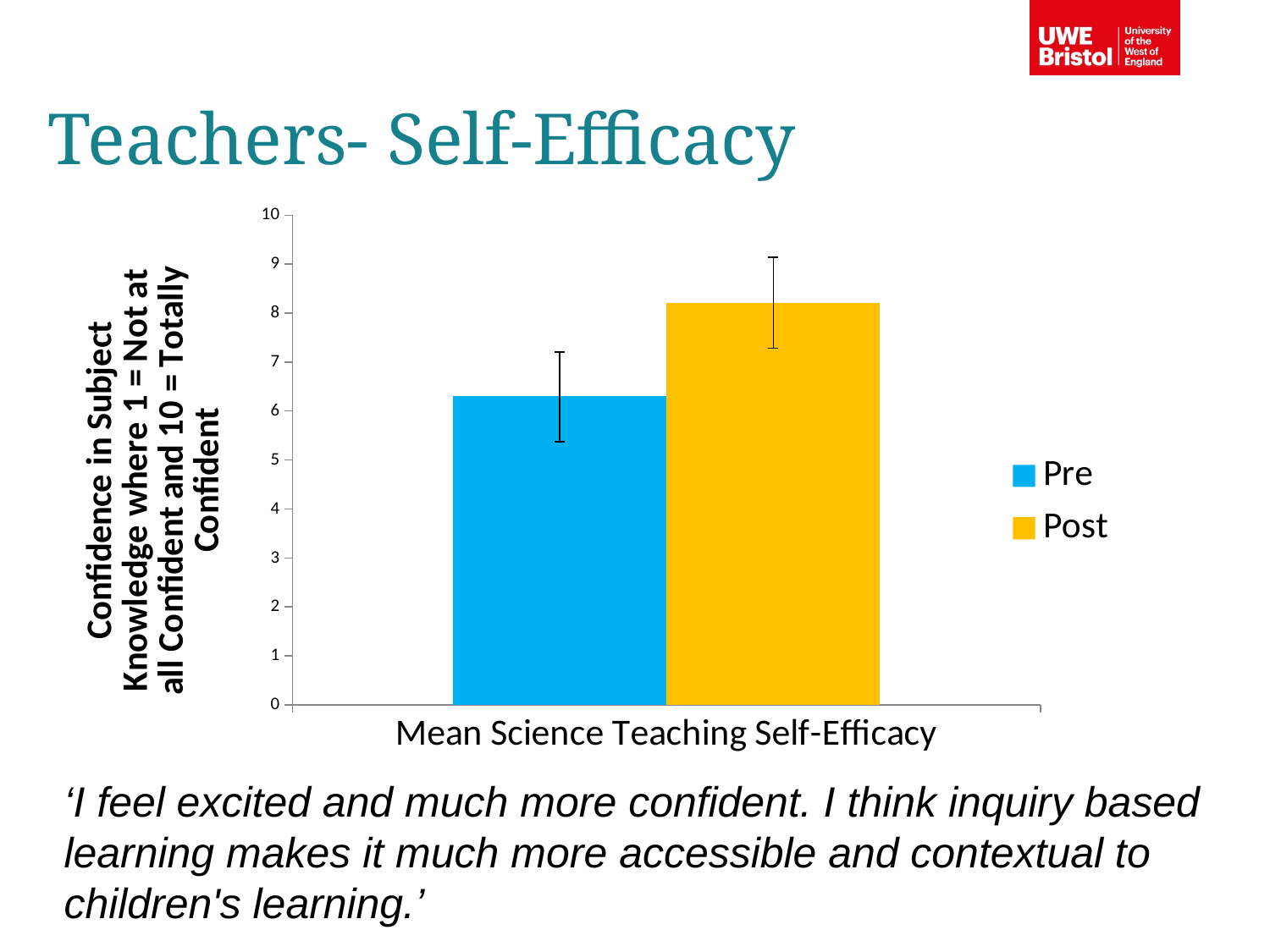
Which series has the higher value, Pre or Post? Post What is the label on the x axis of the chart? Mean Science Teaching Self-Efficacy Is the value for Post greater or less than 7? greater Which series has the lowest bar? Pre How many categories are shown on the x axis? 1 Is the value for Post greater or less than 9? less Is the value for Pre greater or less than 6? greater Which series has the highest bar? Post What colour is the Post series in the chart? Yellow How many series does the legend list? 2 What kind of chart is shown on the slide? Bar chart